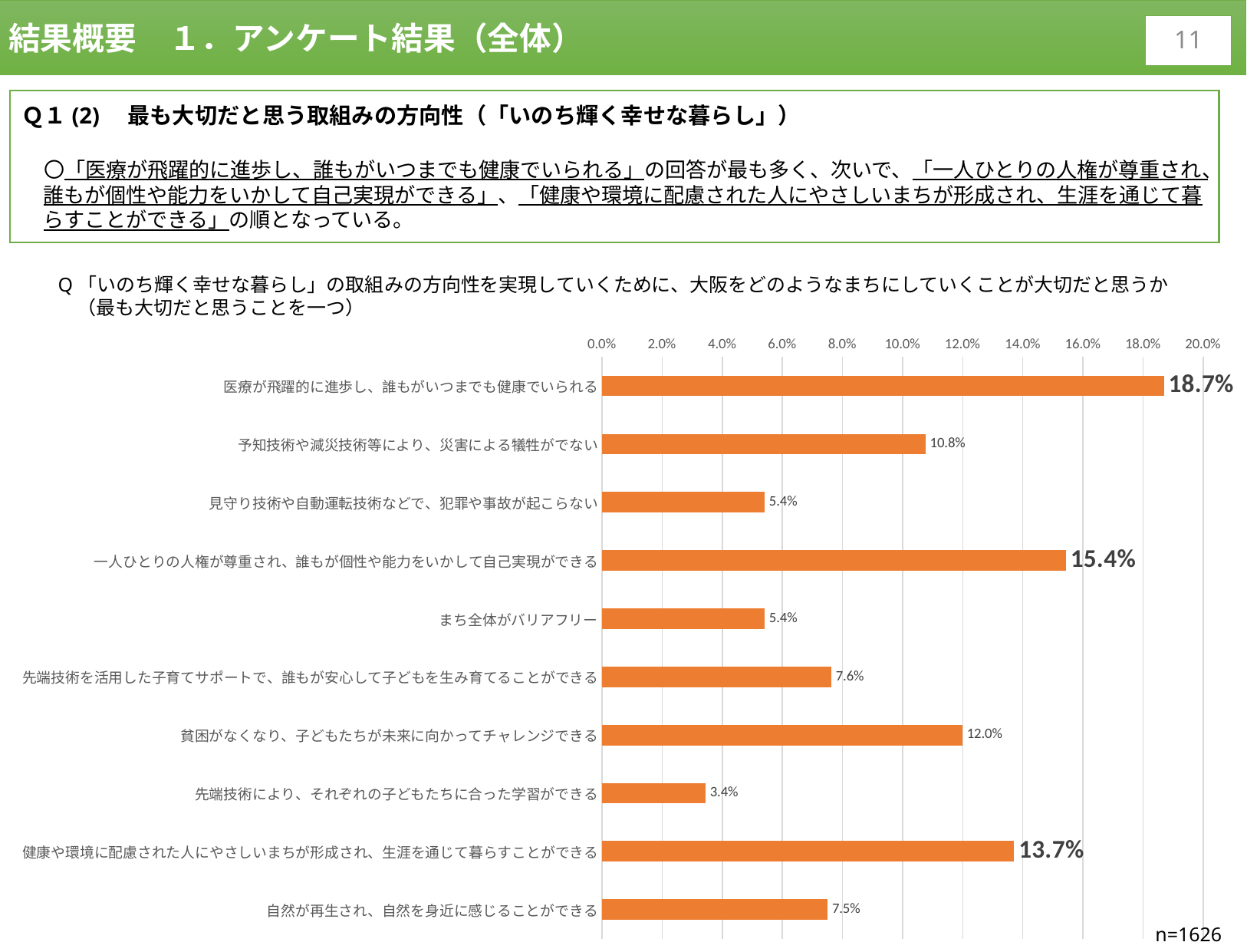
What is the value for 「貧困がなくなり、子どもたちが未来に向かってチャレンジできる」? 12.0% What is the difference between 「一人ひとりの人権が尊重され、誰もが個性や能力をいかして自己実現ができる」 and 「健康や環境に配慮された人にやさしいまちが形成され、生涯を通じて暮らすことができる」? 1.7% What is the difference between the highest value and the lowest value in the chart? 15.3% How many categories are shown in the chart? 10 Is the value for 「自然が再生され、自然を身近に感じることができる」 greater or less than 8.0%? less What is the value for 「まち全体がバリアフリー」? 5.4% Which category has the highest value? 医療が飛躍的に進歩し、誰もがいつまでも健康でいられる Which is larger: 「予知技術や減災技術等により、災害による犠牲がでない」 or 「貧困がなくなり、子どもたちが未来に向かってチャレンジできる」? 貧困がなくなり、子どもたちが未来に向かってチャレンジできる Which category has the lowest value? 先端技術により、それぞれの子どもたちに合った学習ができる What is the sample size (n) shown on the slide? n=1626 What kind of chart is shown on the slide? bar chart What is the value for 「医療が飛躍的に進歩し、誰もがいつまでも健康でいられる」? 18.7%